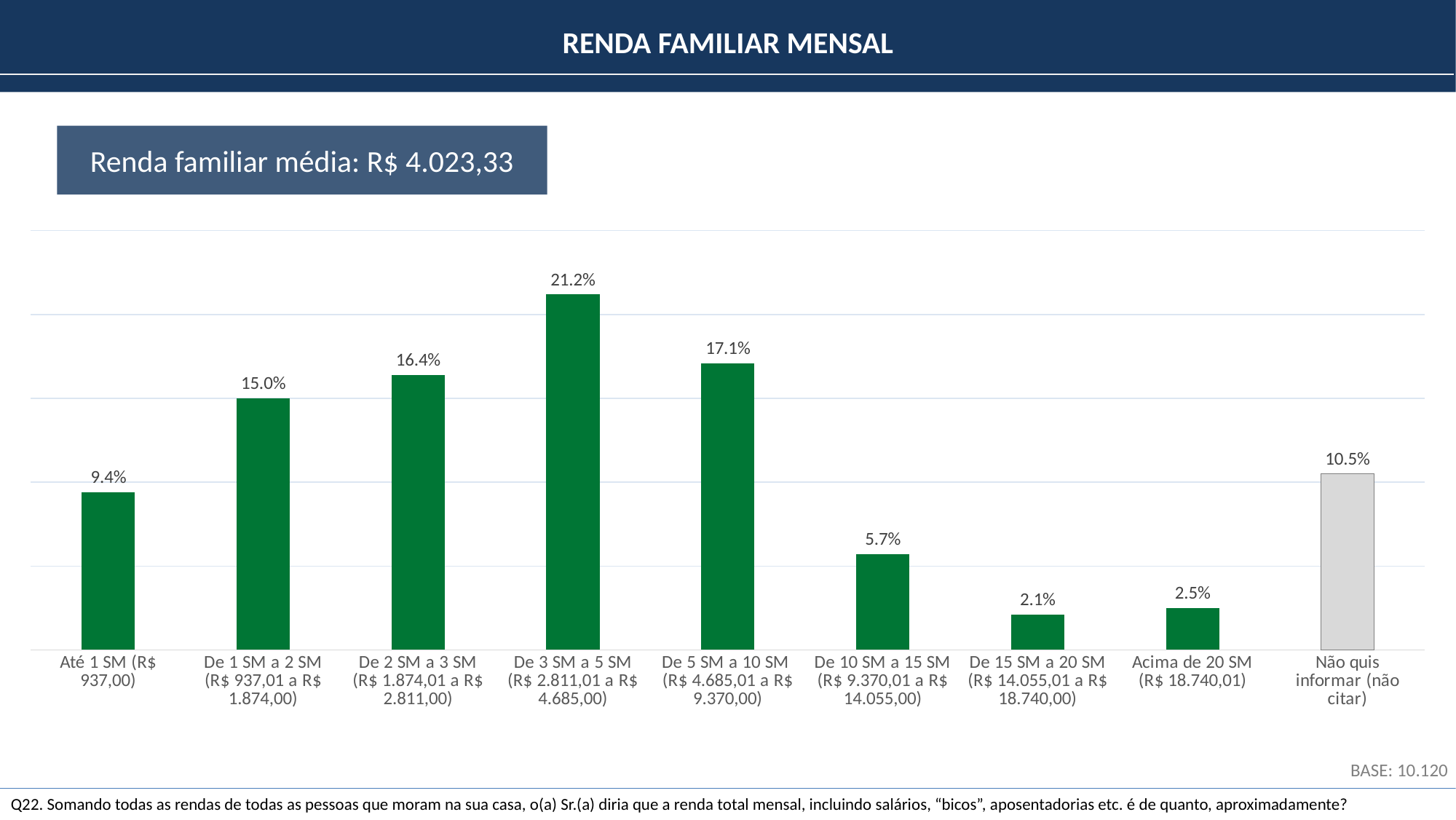
What is the value for the 'De 3 SM a 5 SM' category? 21.2% What is the difference between the values for 'Acima de 20 SM' and 'De 15 SM a 20 SM'? 0.4% Which category has the highest value? De 3 SM a 5 SM What kind of chart is shown on the slide? Bar chart What is the value for 'Não quis informar (não citar)'? 10.5% How many categories are shown on the x axis? 9 What is the average family income stated in the box on the slide? R$ 4.023,33 Which category has the lowest value? De 15 SM a 20 SM What is the difference between the values for 'De 3 SM a 5 SM' and 'De 5 SM a 10 SM'? 4.1% Which is larger, the value for 'De 1 SM a 2 SM' or 'De 2 SM a 3 SM'? De 2 SM a 3 SM What is the base (sample size) shown on the slide? 10.120 What is the value for the 'Até 1 SM' category? 9.4%